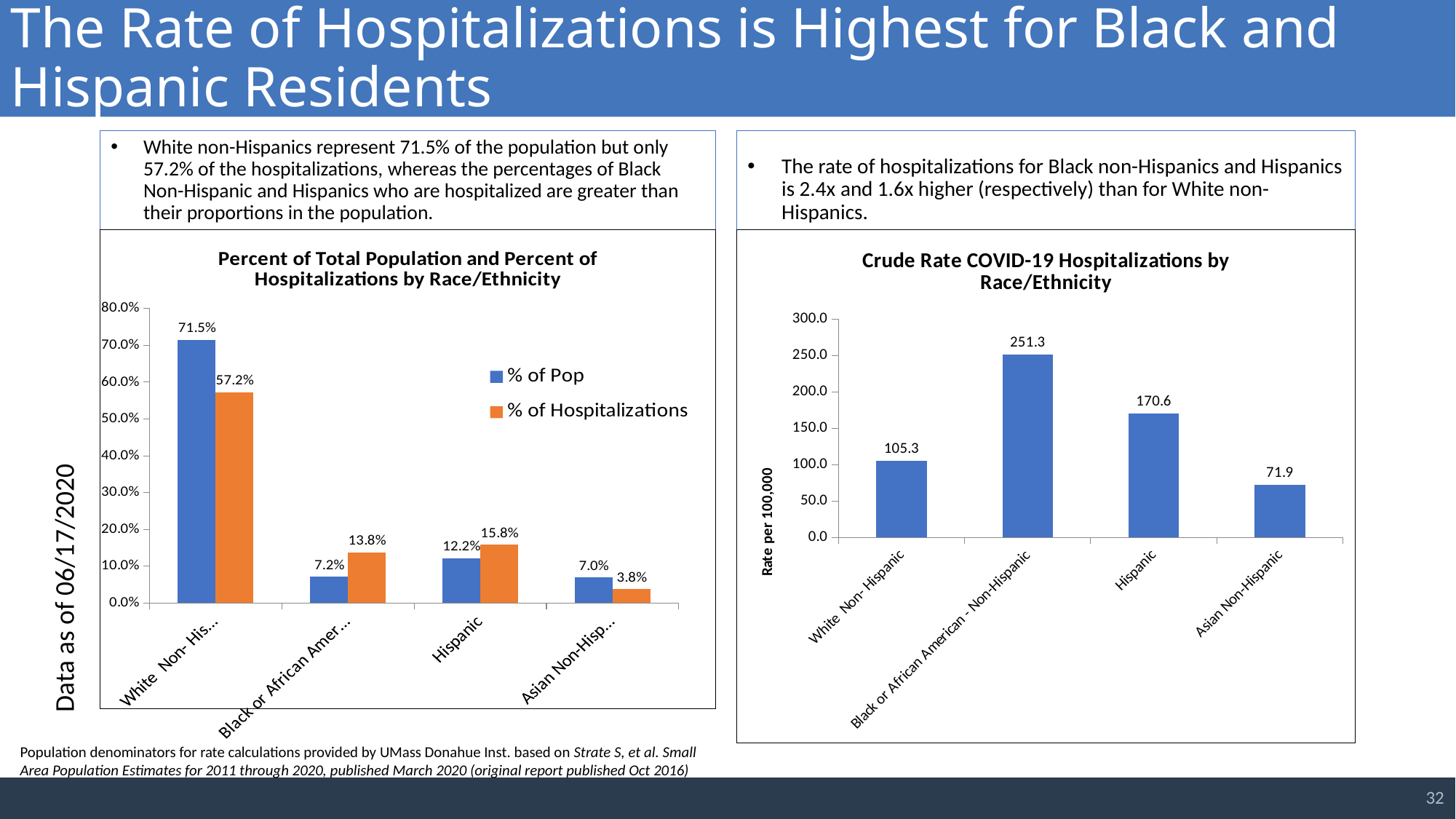
In the 'Percent of Total Population and Percent of Hospitalizations by Race/Ethnicity' chart, what is the % of Hospitalizations value for Hispanic? 15.8% In the 'Crude Rate COVID-19 Hospitalizations by Race/Ethnicity' chart, what is the y-axis label? Rate per 100,000 In the 'Percent of Total Population and Percent of Hospitalizations by Race/Ethnicity' chart, what is the % of Pop value for the first category (White Non-Hispanic)? 71.5% In the 'Percent of Total Population and Percent of Hospitalizations by Race/Ethnicity' chart, which is larger for the Hispanic category: % of Pop or % of Hospitalizations? % of Hospitalizations In the 'Percent of Total Population and Percent of Hospitalizations by Race/Ethnicity' chart, how many series does the legend list? 2 In the 'Crude Rate COVID-19 Hospitalizations by Race/Ethnicity' chart, which category has the lowest rate? Asian Non-Hispanic In the 'Crude Rate COVID-19 Hospitalizations by Race/Ethnicity' chart, which category has the highest rate? Black or African American - Non-Hispanic What kind of chart is the 'Crude Rate COVID-19 Hospitalizations by Race/Ethnicity' chart? Bar chart In the 'Percent of Total Population and Percent of Hospitalizations by Race/Ethnicity' chart, what is the difference between % of Pop and % of Hospitalizations for Hispanic? 3.6% In the 'Crude Rate COVID-19 Hospitalizations by Race/Ethnicity' chart, what is the difference between the rates for Hispanic and White Non-Hispanic? 65.3 In the 'Crude Rate COVID-19 Hospitalizations by Race/Ethnicity' chart, what is the rate for Black or African American - Non-Hispanic? 251.3 In the 'Crude Rate COVID-19 Hospitalizations by Race/Ethnicity' chart, how many categories are shown? 4